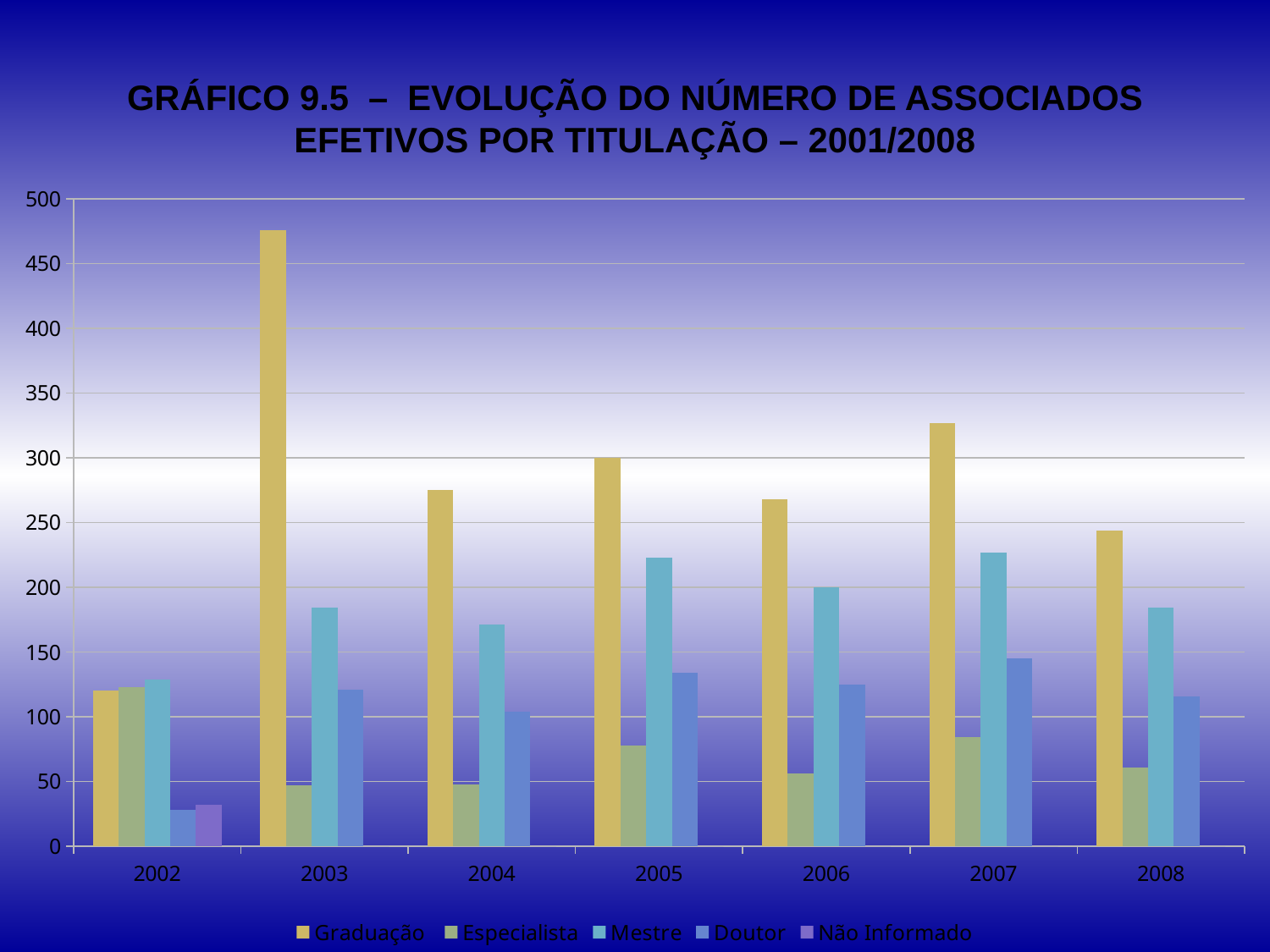
Is the Especialista value for 2003 greater or less than 100? less In 2006, which is larger: Mestre or Doutor? Mestre How many years are shown on the x axis of the chart? 7 In which year is the Doutor value highest? 2007 How many series does the legend list? 5 What kind of chart is shown on the slide? bar chart In 2007, which is larger: Graduação or Mestre? Graduação Is the Graduação value for 2003 greater or less than 450? greater In which year is the Graduação value highest? 2003 In which year is the Doutor value lowest? 2002 Is the Mestre value for 2005 greater or less than 200? greater In which year does a Não Informado bar appear? 2002